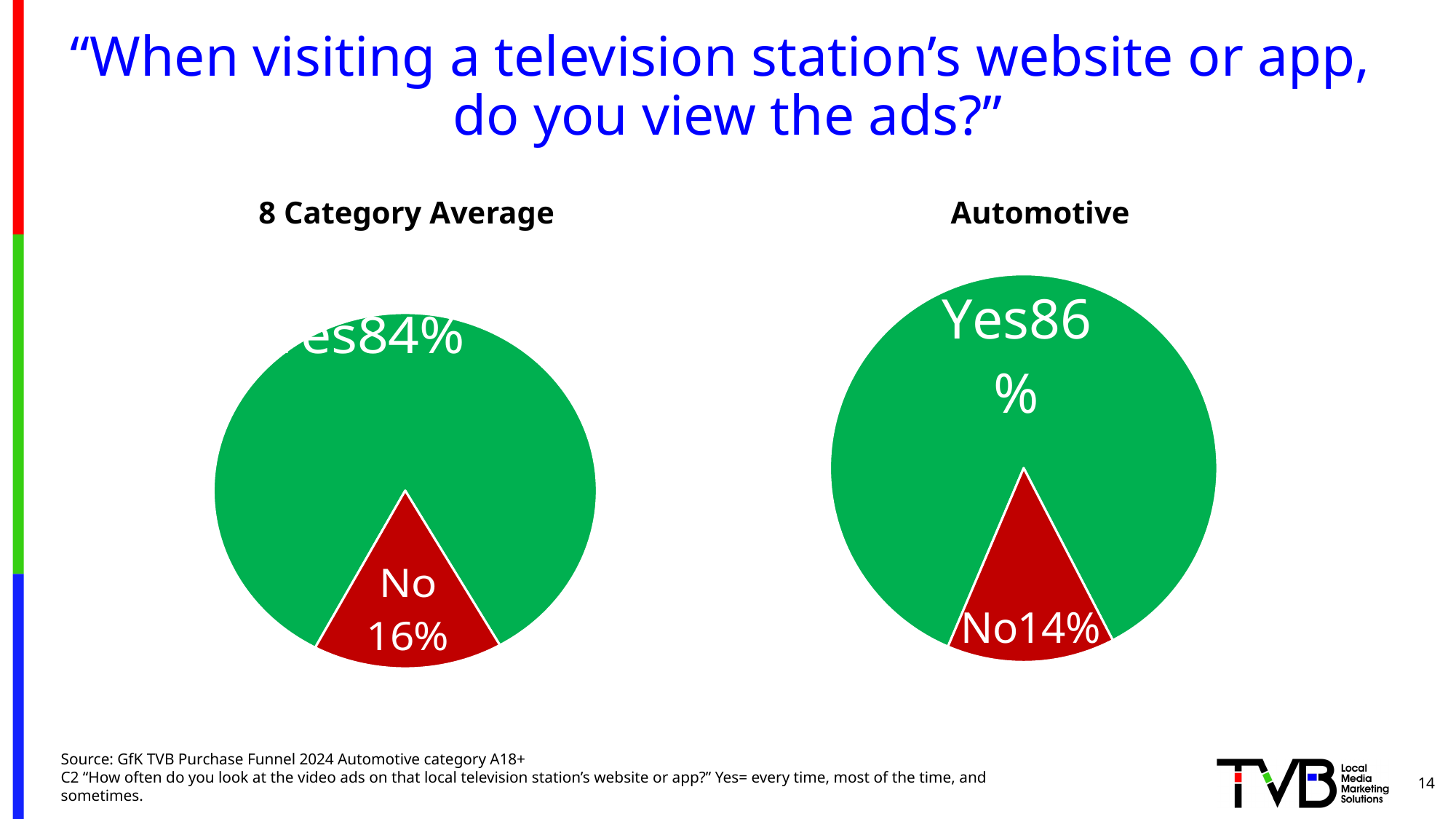
In the 'Automotive' pie chart, which slice is the largest? Yes In the '8 Category Average' pie chart, what percentage answered Yes? 84% In the 'Automotive' pie chart, what colour is the No slice? Red In the 'Automotive' pie chart, what percentage answered No? 14% In the 'Automotive' pie chart, what percentage answered Yes? 86% Is the No share larger in the '8 Category Average' chart or the 'Automotive' chart? 8 Category Average In the '8 Category Average' pie chart, which slice is the smallest? No What is the difference between the Yes share in the 'Automotive' chart and the Yes share in the '8 Category Average' chart? 2% How many pie charts are shown on the slide? 2 How many slices does the '8 Category Average' pie chart have? 2 What type of chart is used for the 'Automotive' data? Pie chart In the '8 Category Average' pie chart, what percentage answered No? 16%